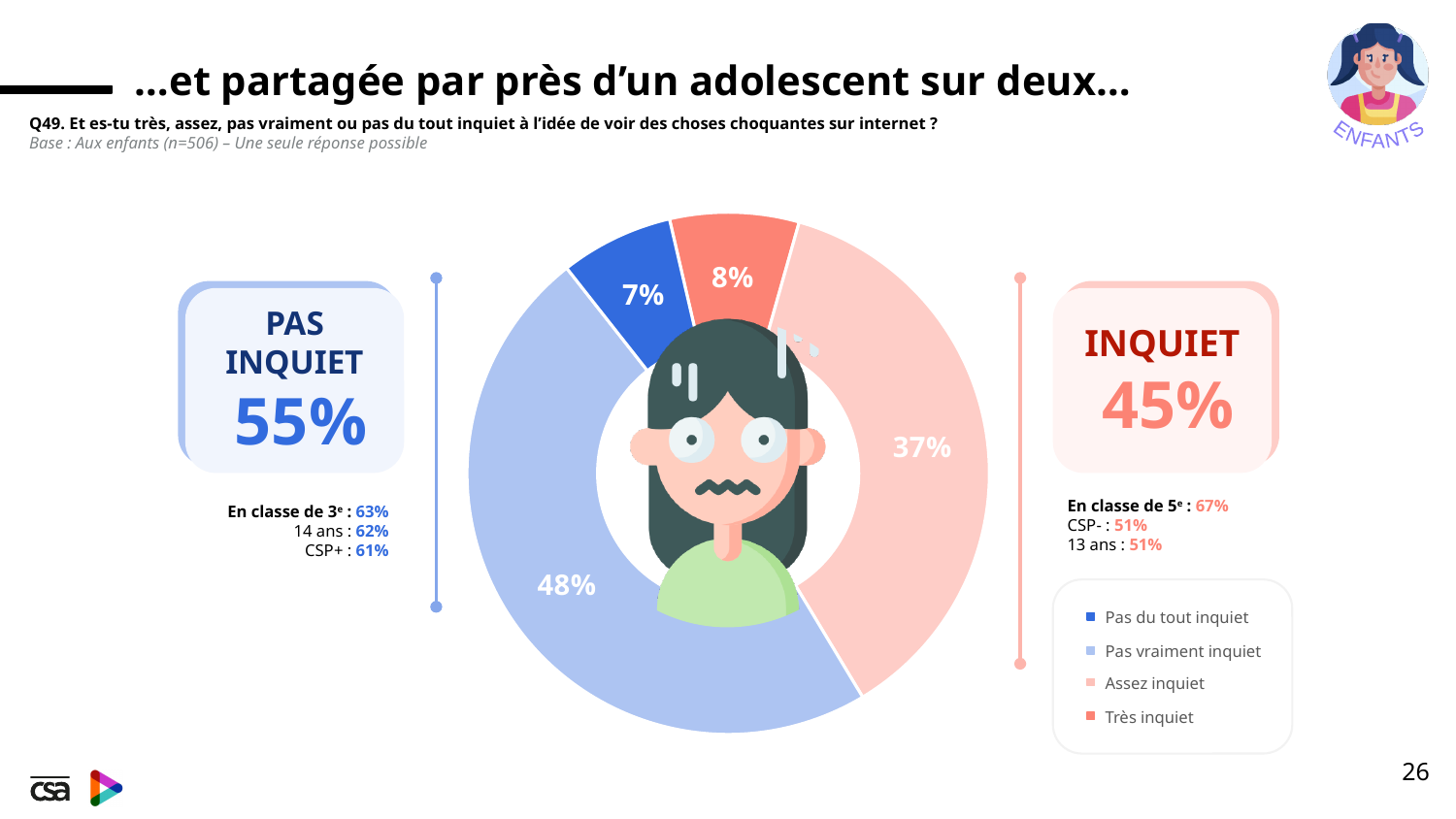
How many slices does the pie chart have? 4 What percentage of children answered "Assez inquiet"? 37% What percentage of children answered "Pas vraiment inquiet"? 48% What percentage of children answered "Très inquiet"? 8% How many entries does the legend list? 4 Which response category has the smallest share of the pie? Pas du tout inquiet Which is larger, the share for "Très inquiet" or the share for "Pas du tout inquiet"? Très inquiet What is the combined share of "Assez inquiet" and "Très inquiet"? 45% Which response category has the largest share of the pie? Pas vraiment inquiet What is the difference in percentage points between "Pas vraiment inquiet" and "Assez inquiet"? 11 What kind of chart is shown on the slide? pie chart What percentage of children answered "Pas du tout inquiet"? 7%